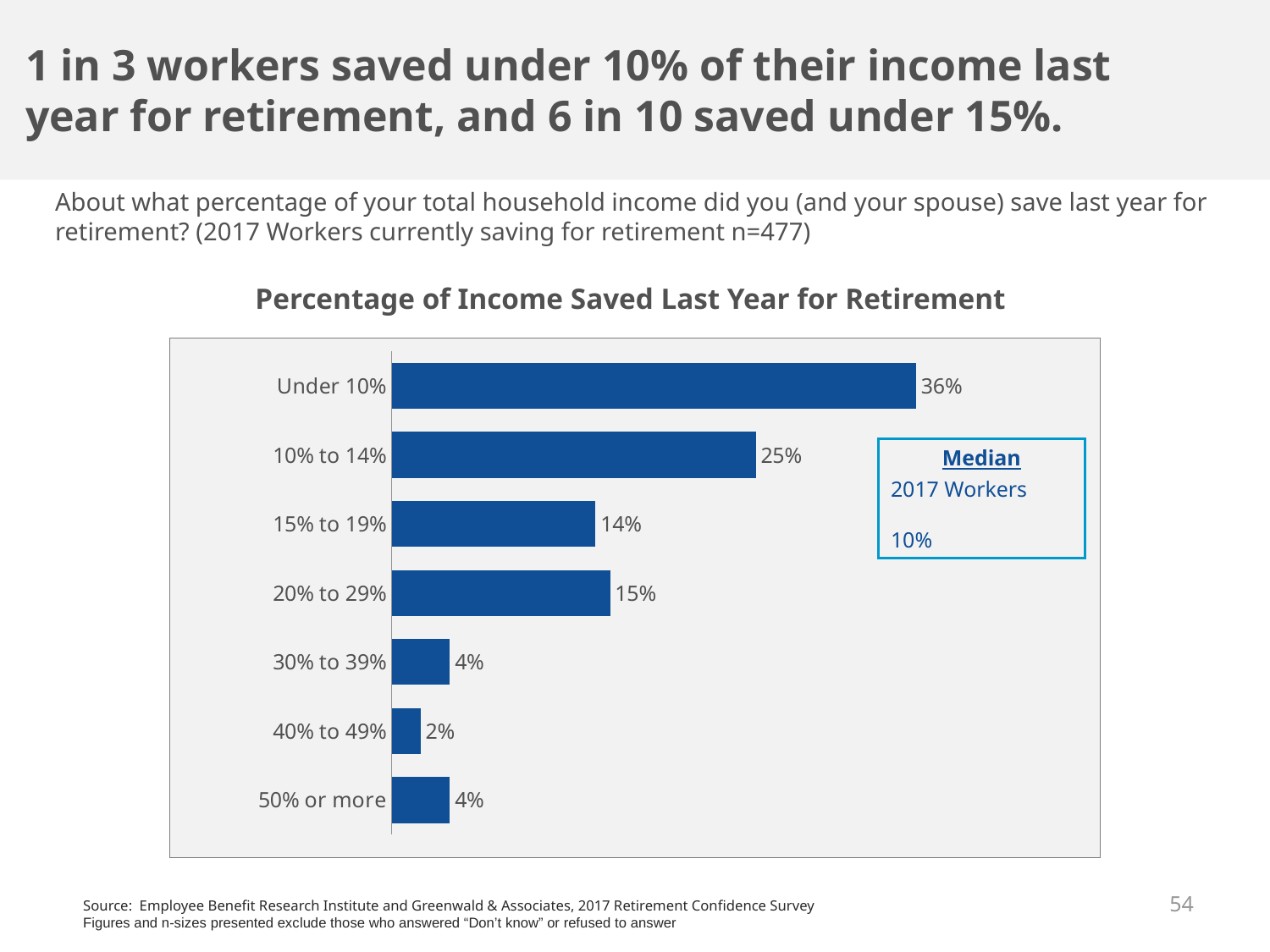
Which category has the lowest value? 40% to 49% What median value is shown in the box for 2017 Workers? 10% What percentage of workers saved under 10% of their income last year for retirement? 36% How many categories are shown in the chart? 7 What is the title of the chart? Percentage of Income Saved Last Year for Retirement Which category has the highest value? Under 10% What is the value for the '40% to 49%' category? 2% What is the combined value of the '30% to 39%' and '50% or more' categories? 8% What kind of chart is shown on the slide? Bar chart Which is larger, the value for '15% to 19%' or the value for '20% to 29%'? 20% to 29% What is the difference between the values for 'Under 10%' and '10% to 14%'? 11% What is the value for the '20% to 29%' category? 15%